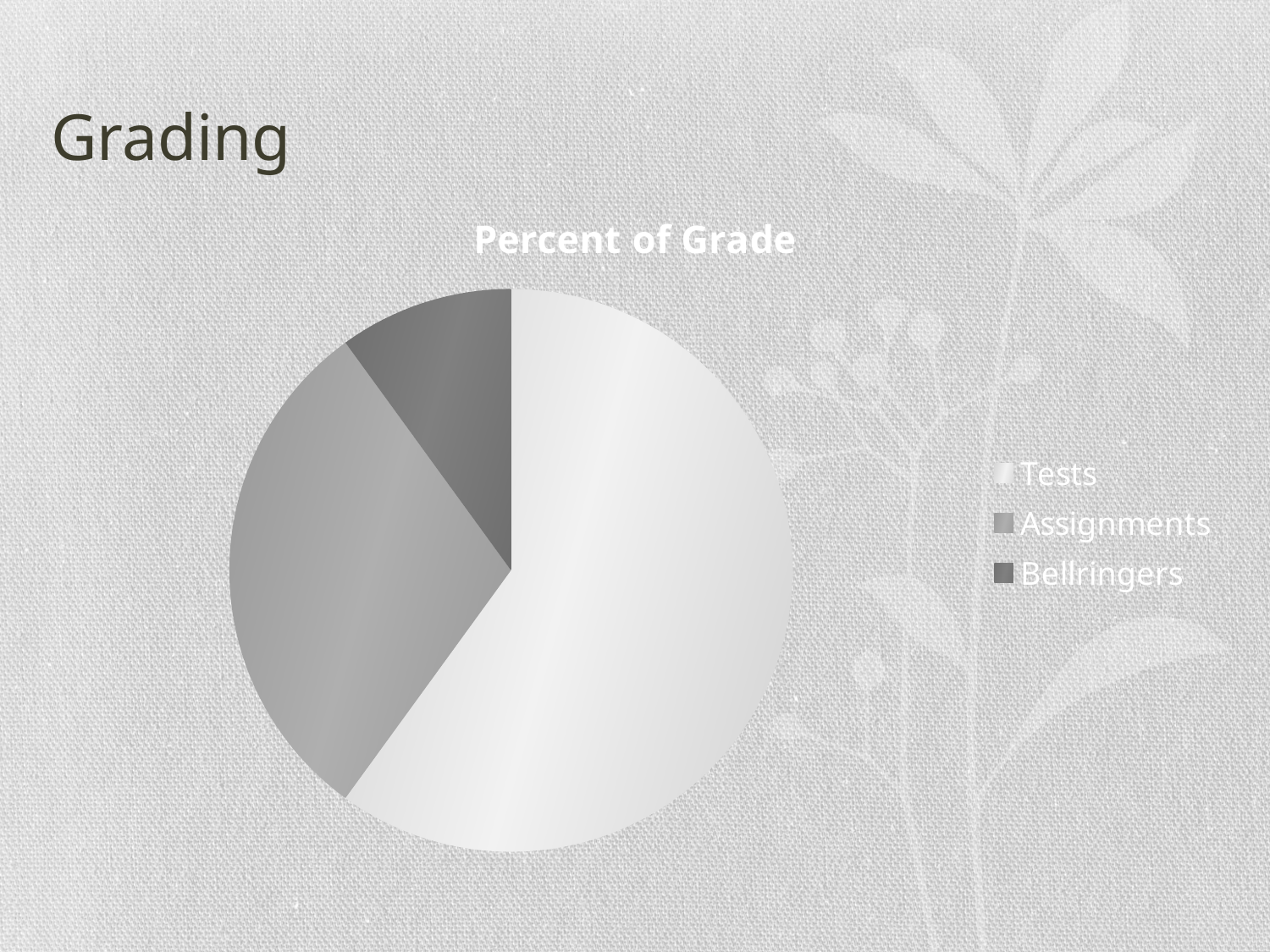
How many categories does the pie chart have? 3 Which slice is larger, Tests or Assignments? Tests Which categories are listed in the legend? Tests, Assignments, Bellringers Does the Tests slice make up more or less than half of the pie? more Which category has the smallest slice of the pie? Bellringers Which slice is larger, Assignments or Bellringers? Assignments Which category has the largest slice of the pie? Tests What is the title of the chart? Percent of Grade What kind of chart is shown on the slide? pie chart